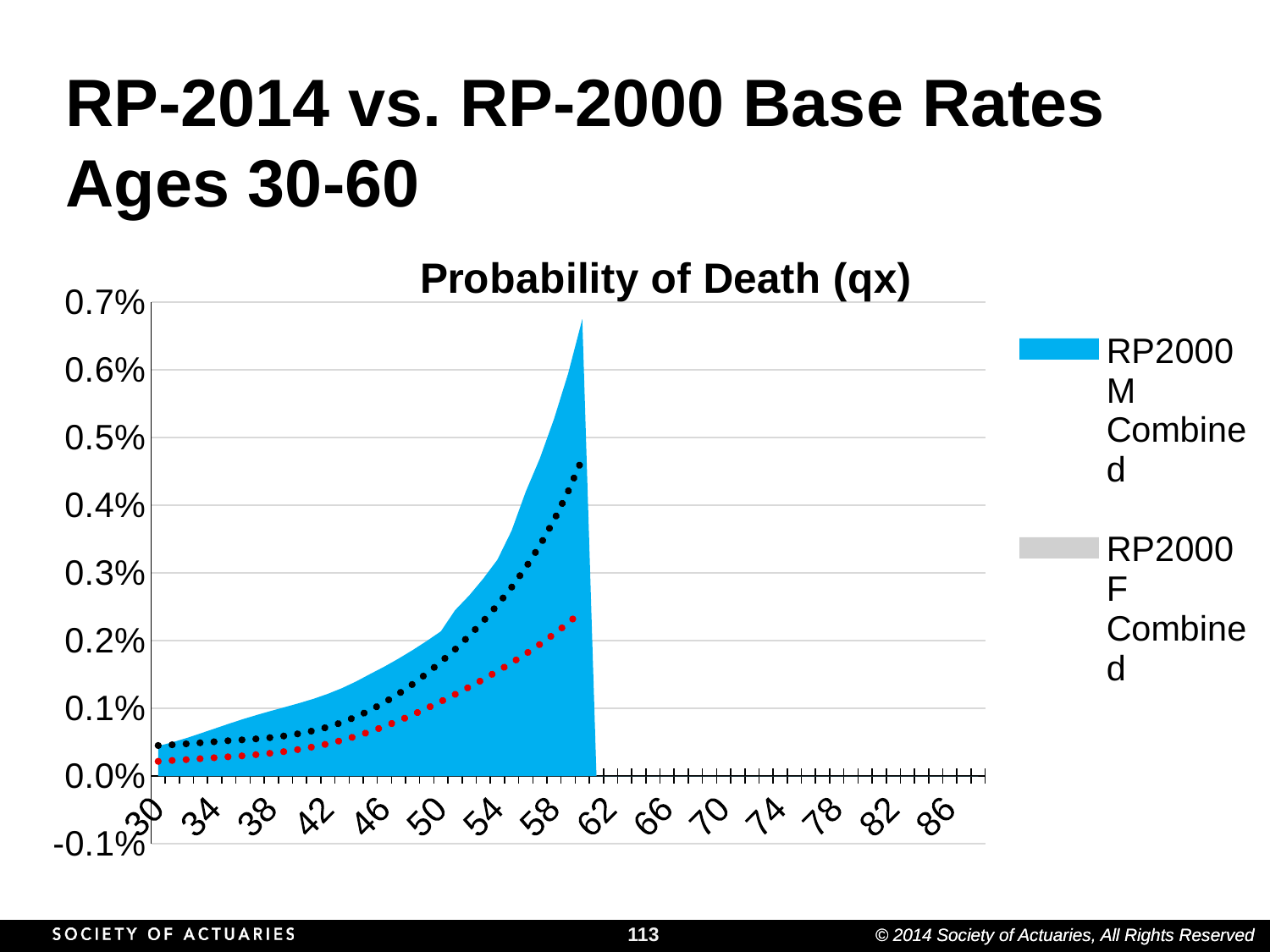
Is the value of the blue RP2000 M Combined area at age 30 greater or less than 0.1%? less What kind of chart is shown on the slide? combination area and line chart At age 60, which is larger: the black dotted line or the red dotted line? the black dotted line At which age does the blue RP2000 M Combined area reach its highest value? 60 Do the plotted probability of death values rise or fall as age increases from 30 to 60? rise Is the peak value of the blue RP2000 M Combined area at age 60 greater or less than 0.6%? greater How many series does the chart legend list? 2 At which age is the blue RP2000 M Combined area at its lowest value? 30 Is the value of the black dotted line at age 60 greater or less than 0.4%? greater Which colour represents the RP2000 M Combined series in the legend? blue What is the title of the chart? Probability of Death (qx)